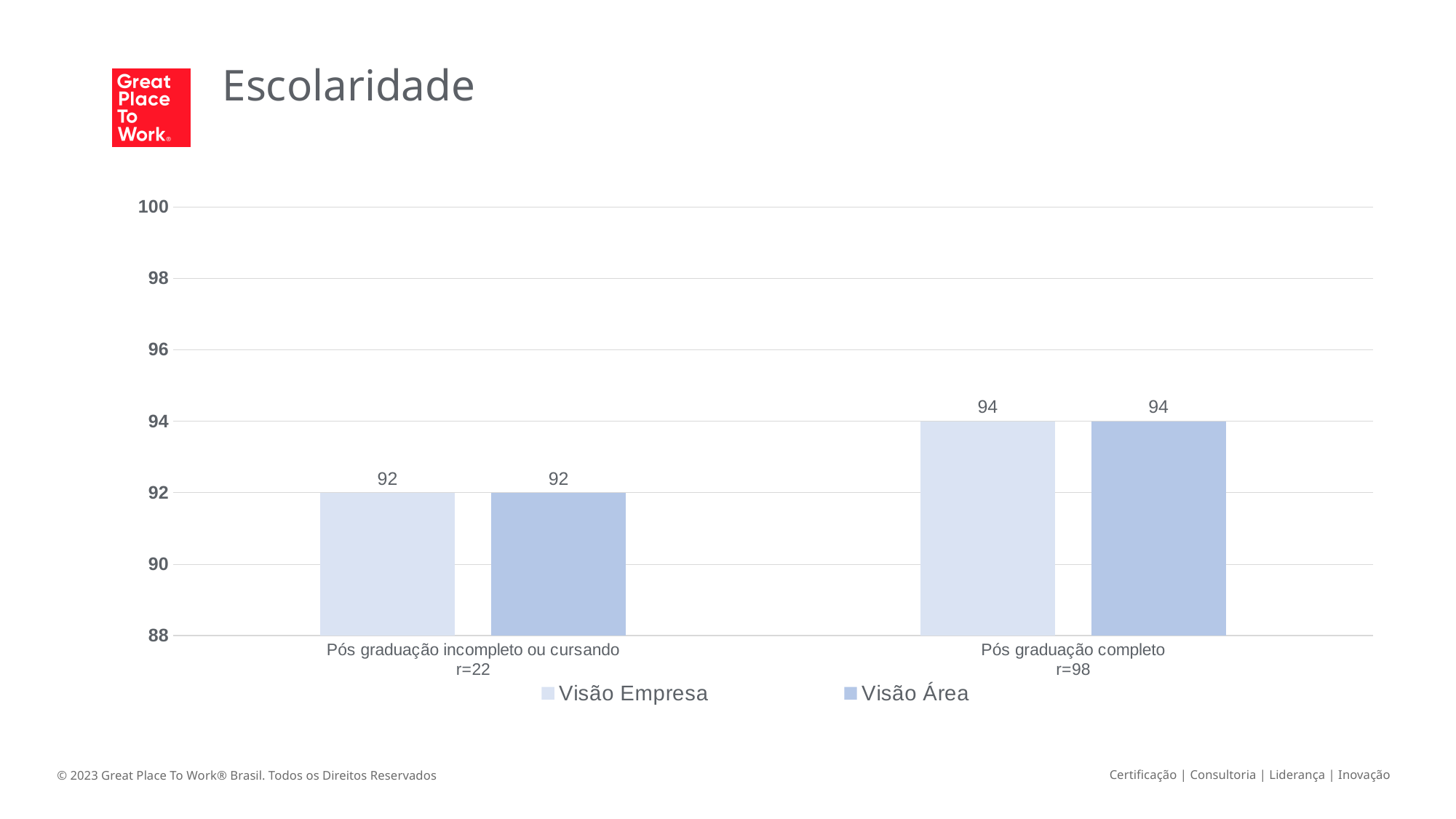
What is the Visão Área value for Pós graduação incompleto ou cursando? 92 Which category has the highest Visão Empresa value? Pós graduação completo Which category has the lowest Visão Área value? Pós graduação incompleto ou cursando What is the Visão Empresa value for Pós graduação completo? 94 What is the Visão Área value for Pós graduação completo? 94 Which is larger: the Visão Área value for Pós graduação completo or for Pós graduação incompleto ou cursando? Pós graduação completo What is the title of the slide? Escolaridade What kind of chart is shown on the slide? Bar chart How many categories are shown on the x axis? 2 What is the Visão Empresa value for Pós graduação incompleto ou cursando? 92 How many series does the legend list? 2 What is the difference between the Visão Empresa values for Pós graduação completo and Pós graduação incompleto ou cursando? 2